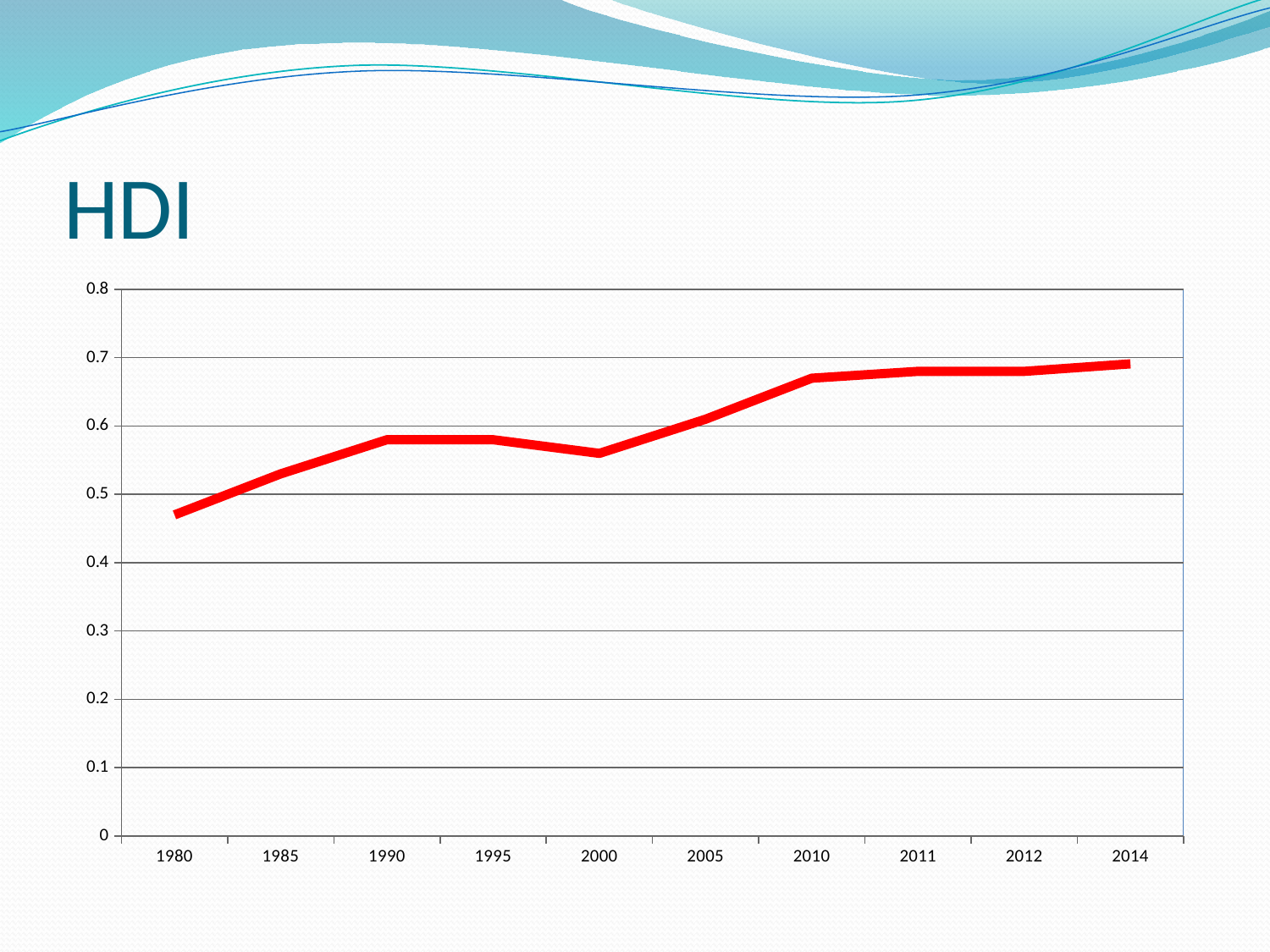
How many years are plotted along the x axis? 10 Which year has the lowest HDI value? 1980 Is the value for 1980 greater or less than 0.5? less Overall, do the values rise or fall from 1980 to 2014? rise Is the value for 2000 greater or less than 0.5? greater What kind of chart is shown on the slide? line chart Which is larger, the value for 1995 or the value for 2000? 1995 What is the title of the slide containing the chart? HDI Is the value for 1990 greater or less than 0.6? less Which is larger, the value for 1980 or the value for 2000? 2000